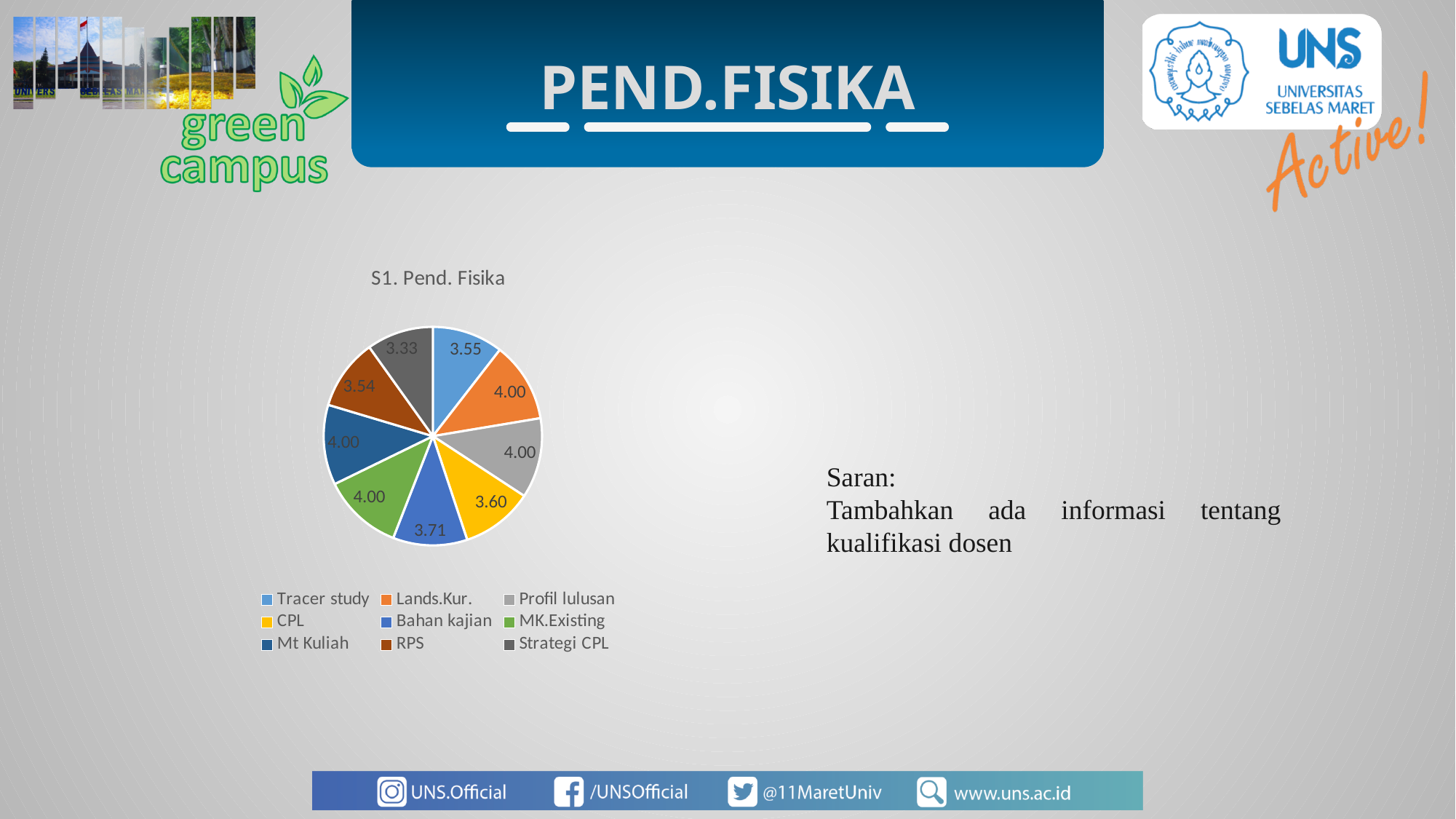
What is the value for RPS in the pie chart? 3.54 Which category has the lowest value in the pie chart? Strategi CPL What is the value for Tracer study in the S1. Pend. Fisika pie chart? 3.55 What is the value for Bahan kajian in the pie chart? 3.71 Which has the larger value, Bahan kajian or CPL? Bahan kajian What is the difference between the values for Bahan kajian and CPL? 0.11 What is the value for Lands.Kur. in the pie chart? 4.00 What is the difference between the values for Lands.Kur. and Tracer study? 0.45 What is the value for CPL in the pie chart? 3.60 What type of chart is shown on the slide? Pie chart How many categories are shown in the pie chart? 9 What is the value for Strategi CPL in the pie chart? 3.33